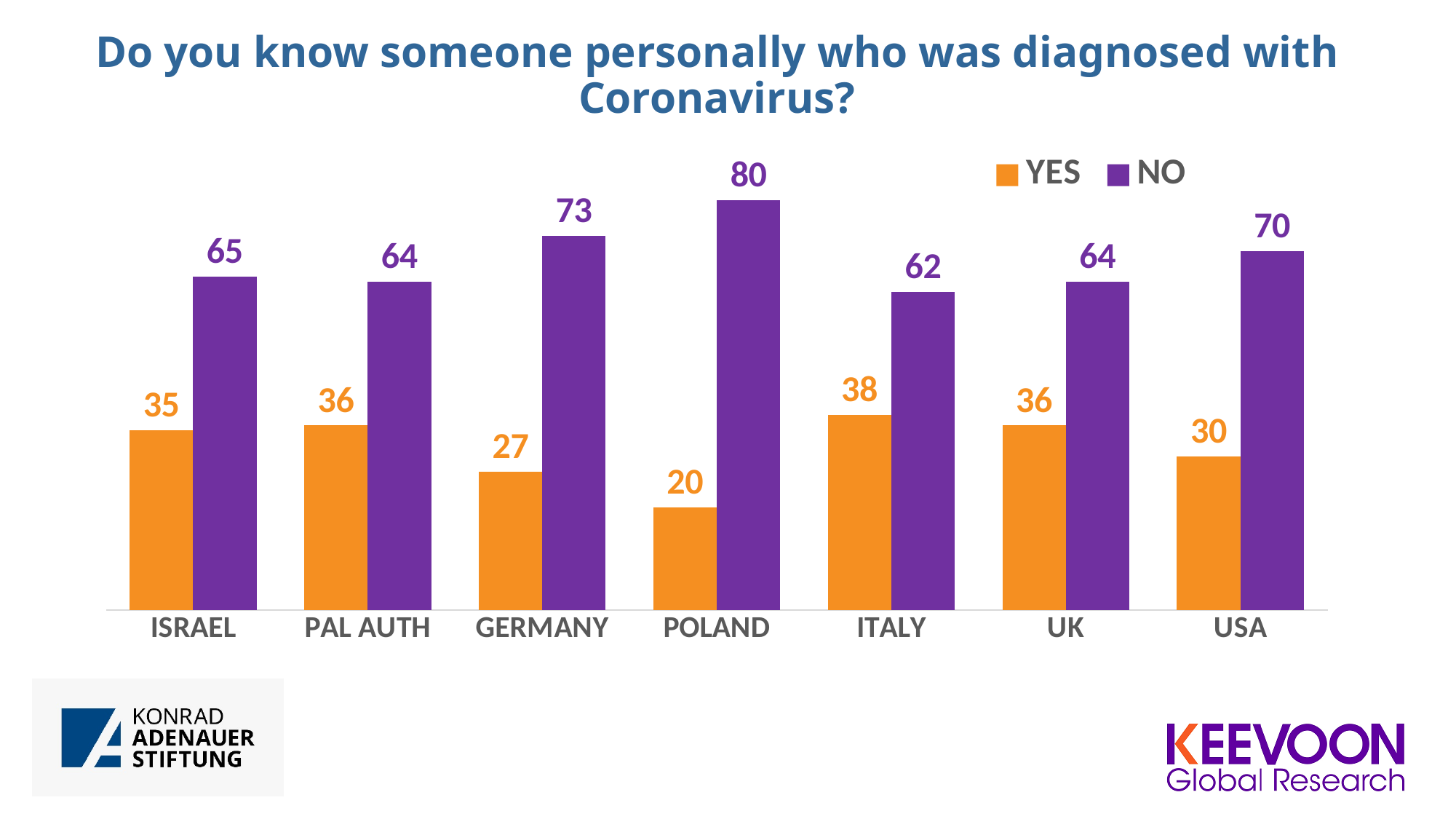
How many countries are shown on the x axis? 7 Which country has the lowest YES value? Poland What is the total of the YES and NO values for Italy? 100 Which is larger, the YES value for Israel or the YES value for Germany? Israel Which country has the highest NO value? Poland How many series does the legend list? 2 What is the YES value for Poland? 20 What is the YES value for Italy? 38 What is the NO value for Germany? 73 What kind of chart is shown on the slide? Bar chart What is the difference between the NO and YES values for the USA? 40 Which colour represents the NO series in the legend? Purple